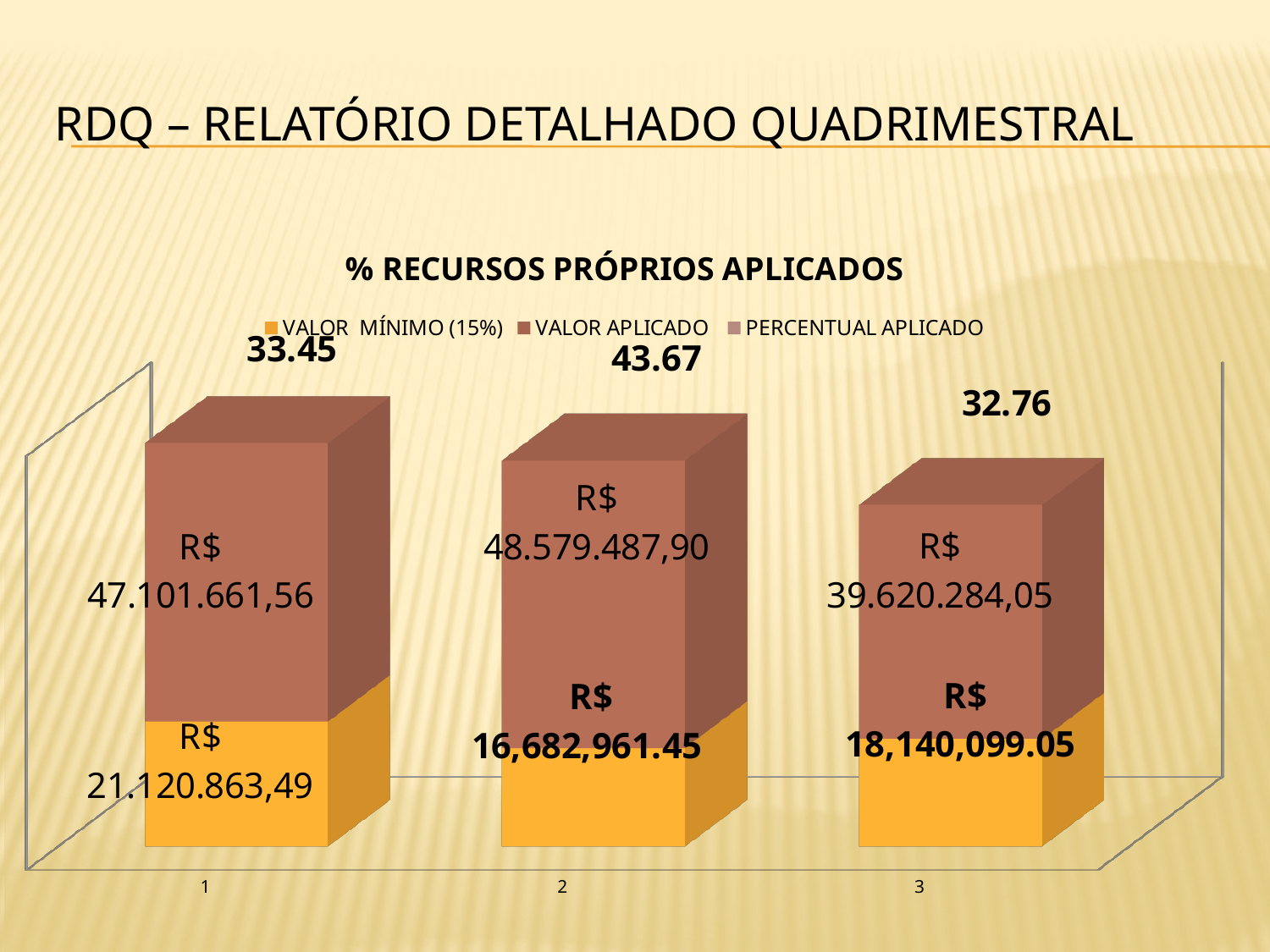
What is the PERCENTUAL APLICADO for category 3? 32.76 Which category has the lowest VALOR MÍNIMO (15%)? 2 How many categories are shown on the x axis? 3 What is the VALOR MÍNIMO (15%) for category 1? R$ 21.120.863,49 What is the VALOR MÍNIMO (15%) for category 2? R$ 16,682,961.45 Is the VALOR APLICADO for category 2 larger or smaller than for category 3? larger How many series does the legend list? 3 Which category has the lowest VALOR APLICADO? 3 What is the title of the chart? % RECURSOS PRÓPRIOS APLICADOS What is the VALOR APLICADO for category 1? R$ 47.101.661,56 Which category has the highest PERCENTUAL APLICADO? 2 What is the difference between the PERCENTUAL APLICADO of category 2 and category 1? 10.22